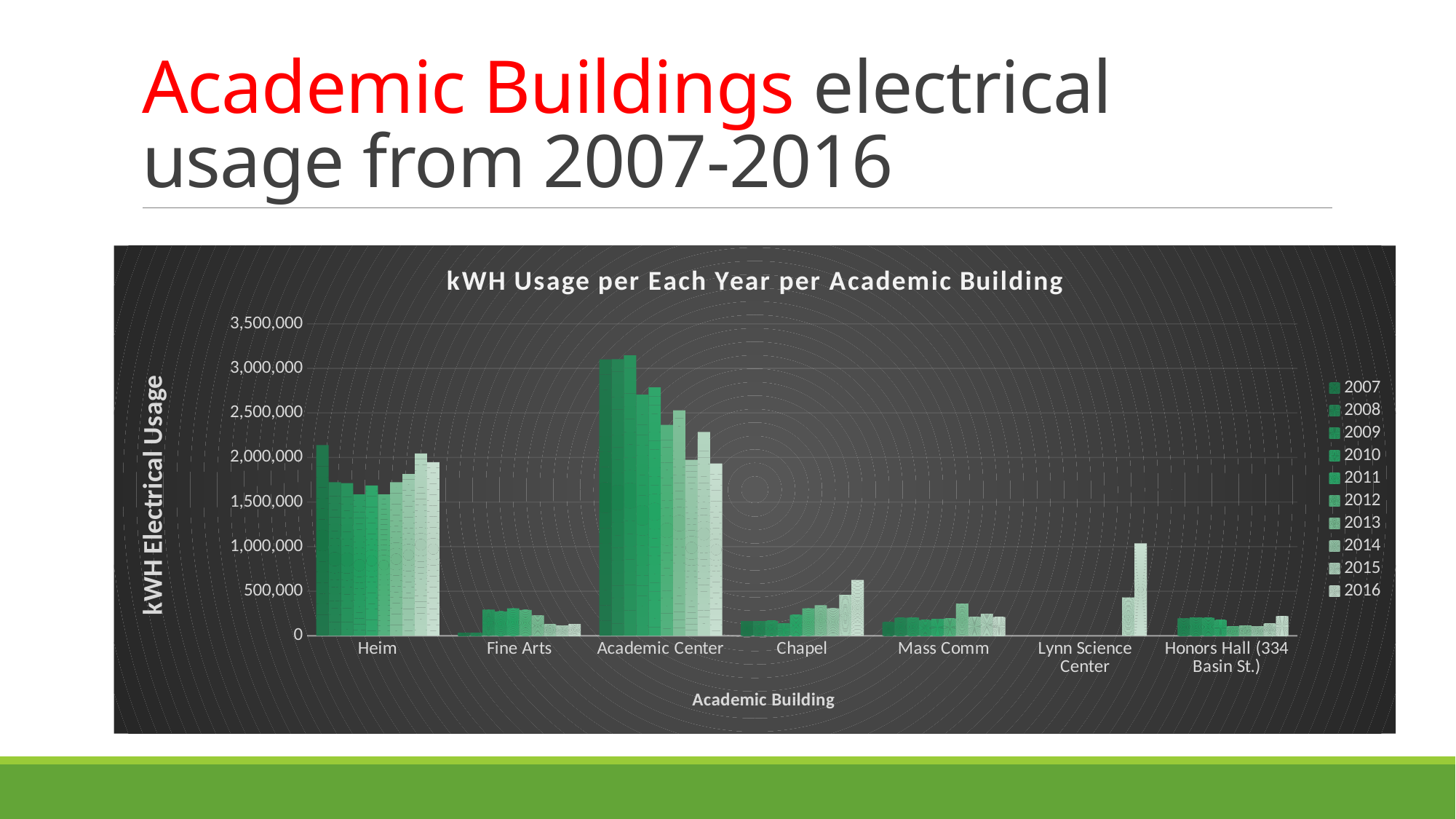
Is the value for Heim in 2007 greater or less than 1,500,000? greater What kind of chart is shown on the slide? bar chart Is the value for Lynn Science Center in 2016 greater or less than 500,000? greater Is the value for Academic Center in 2009 greater or less than 3,000,000? greater Which academic building has the tallest bars in the chart? Academic Center Do the values for Academic Center generally rise or fall from 2007 to 2016? fall Which is larger, the 2016 value for Heim or the 2016 value for Fine Arts? Heim How many academic buildings are shown on the x axis of the chart? 7 How many series (years) does the chart legend list? 10 What is the label on the vertical axis of the chart? kWH Electrical Usage What is the title of the chart? kWH Usage per Each Year per Academic Building